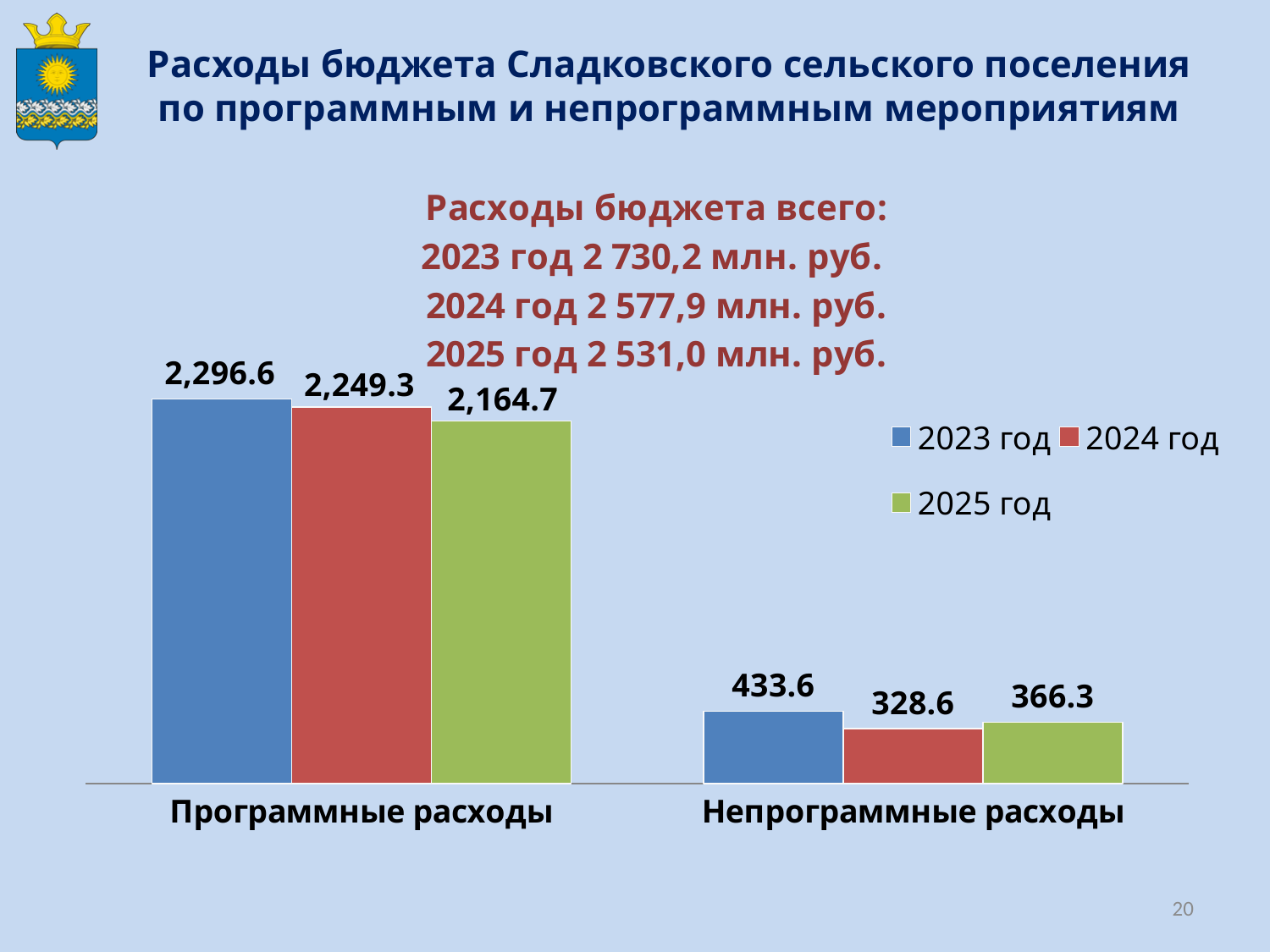
Which is larger for Непрограммные расходы: the 2024 год value or the 2025 год value? 2025 год What is the value for Программные расходы in 2023 год? 2,296.6 What is the difference between the 2025 год and 2024 год values for Непрограммные расходы? 37.7 What is the value for Программные расходы in 2025 год? 2,164.7 How many categories are shown on the x axis? 2 What is the difference between the 2023 год and 2024 год values for Программные расходы? 47.3 What kind of chart is shown on the slide? Bar chart Which year has the highest value for Непрограммные расходы? 2023 год What is the value for Непрограммные расходы in 2025 год? 366.3 How many series does the legend list? 3 Which year has the lowest value for Программные расходы? 2025 год What is the value for Непрограммные расходы in 2024 год? 328.6